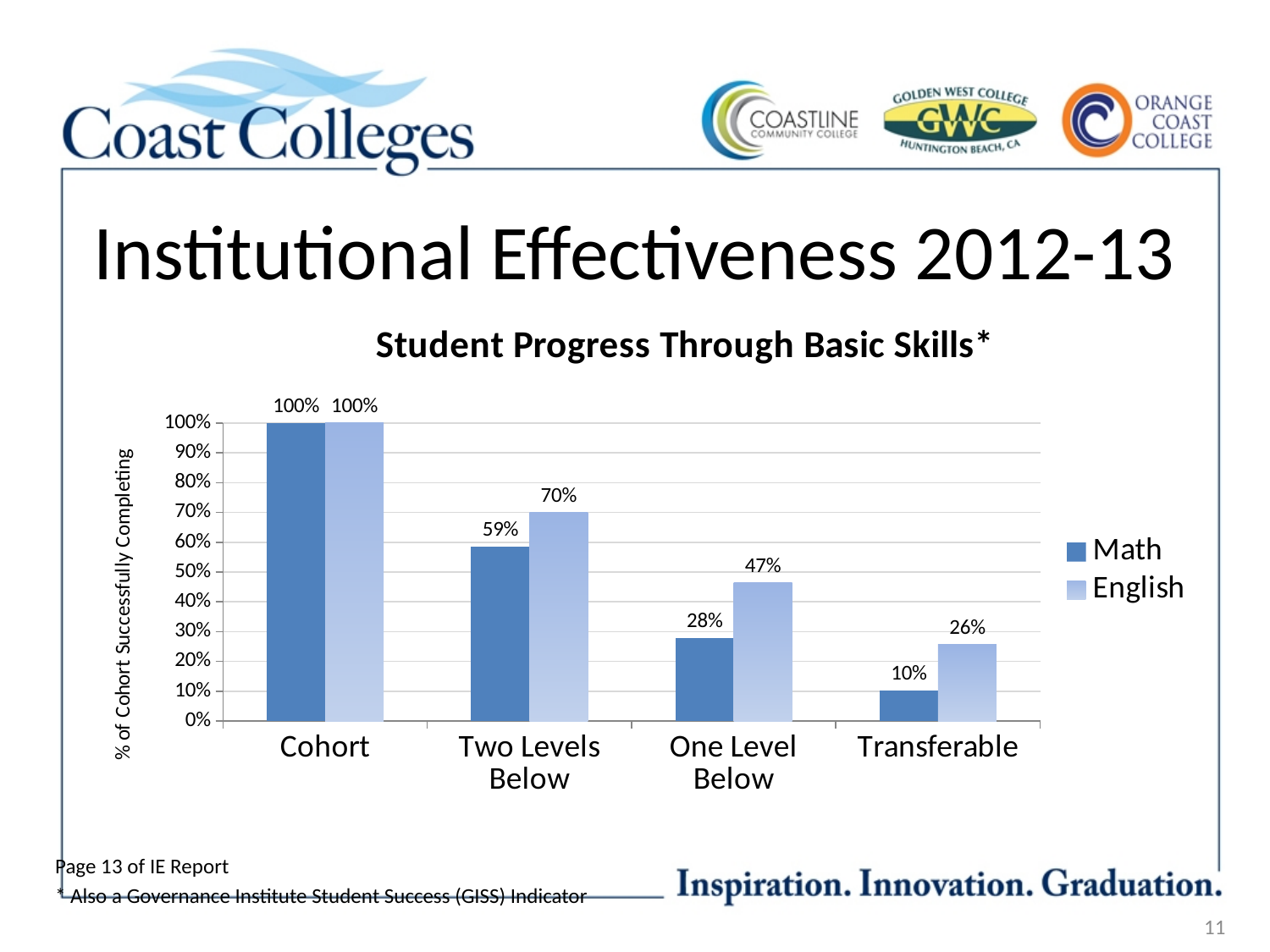
What is the difference between the English and Math values for Two Levels Below? 11% How many categories are shown on the x axis? 4 Which is larger for Transferable, the Math value or the English value? English Which category has the lowest Math value? Transferable What is the difference between the English and Math values for One Level Below? 19% What is the title of the chart? Student Progress Through Basic Skills* What kind of chart is shown? Bar chart What is the Math value for Transferable? 10% How many series does the legend list? 2 What is the Math value for Two Levels Below? 59% What is the English value for Transferable? 26% What is the English value for One Level Below? 47%